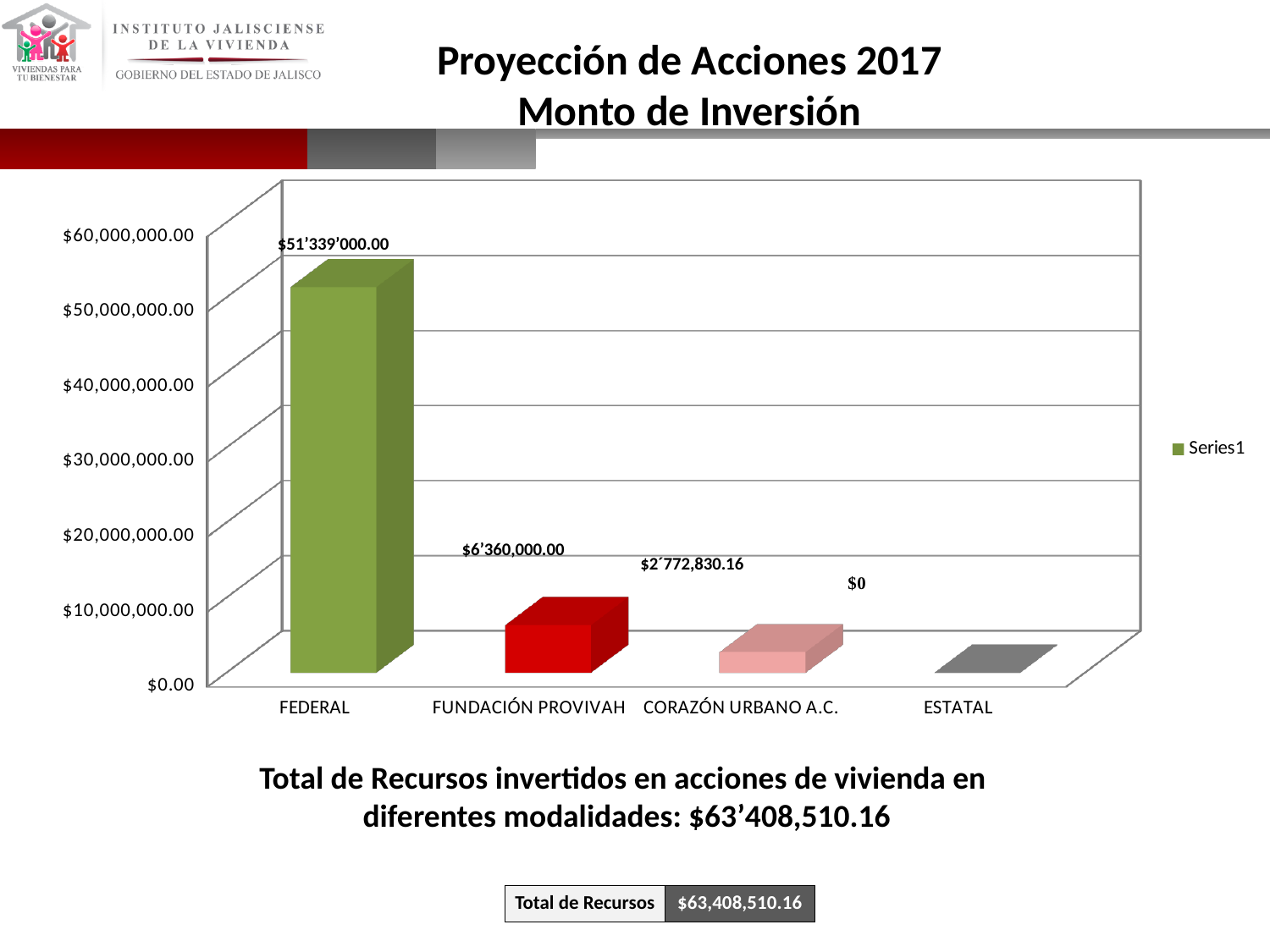
What is the name of the series shown in the legend? Series1 What kind of chart is shown on the slide? bar chart How many categories are shown on the x axis? 4 What is the value for CORAZÓN URBANO A.C.? $2´772,830.16 Which category has the lowest value? ESTATAL Which category has the highest value? FEDERAL Which is larger, FUNDACIÓN PROVIVAH or CORAZÓN URBANO A.C.? FUNDACIÓN PROVIVAH What is the value for FEDERAL? $51'339'000.00 Is the value for FUNDACIÓN PROVIVAH greater or less than $10,000,000.00? less What is the value for FUNDACIÓN PROVIVAH? $6'360,000.00 How many series does the legend list? 1 What is the value for ESTATAL? $0